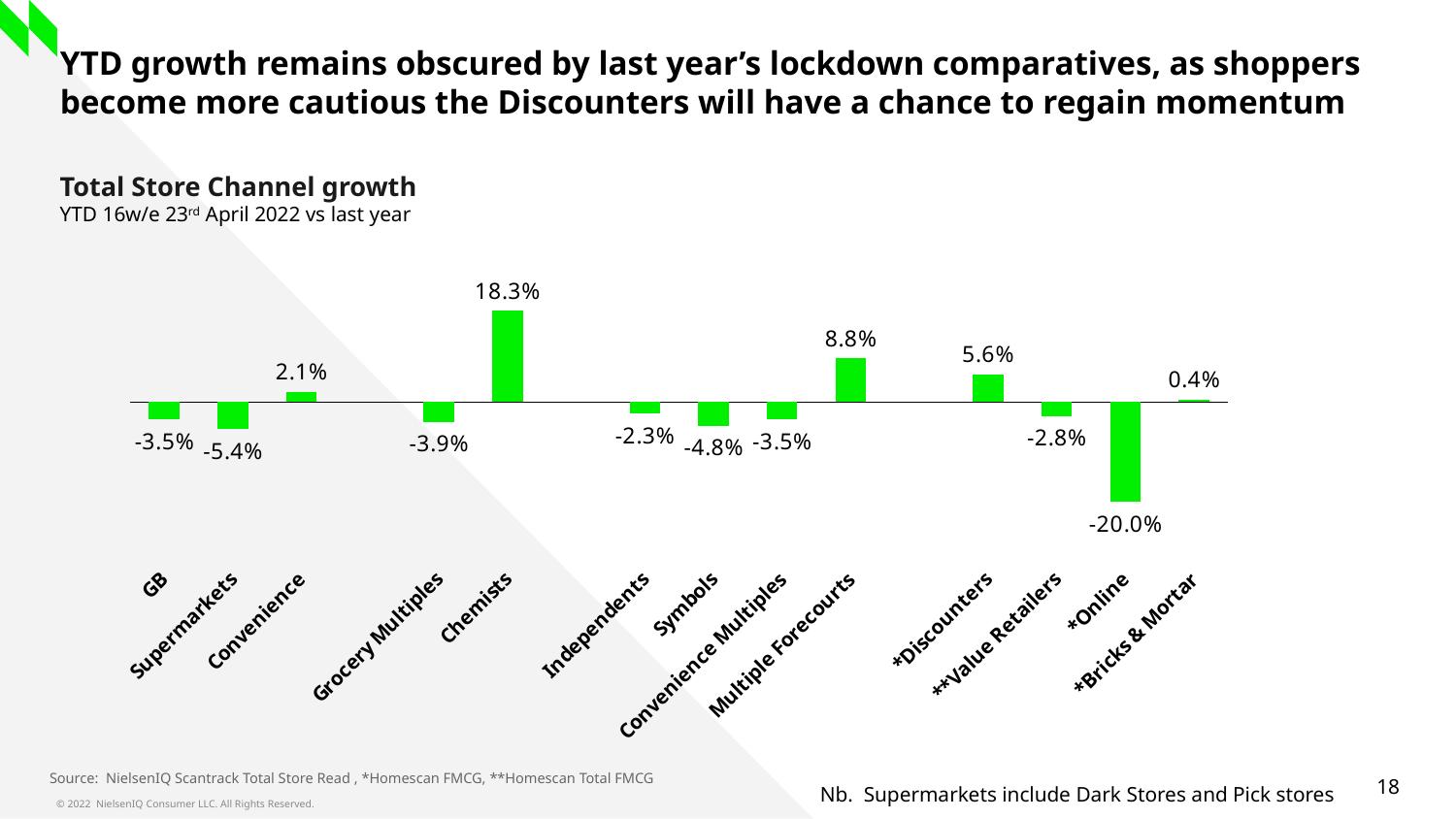
What is the difference between the growth values for Multiple Forecourts and *Discounters? 3.2 percentage points Which channel has the lowest growth value? *Online What is the title of the chart? Total Store Channel growth How many channels are shown in the chart? 13 Which channel has the highest growth value? Chemists What colour are the bars in the chart? Green What kind of chart is shown on the slide? Bar chart What is the growth value for Chemists? 18.3% What is the growth value for Supermarkets? -5.4% What is the growth value for *Discounters? 5.6% What is the growth value for *Online? -20.0% Which has the larger growth value, Convenience or *Bricks & Mortar? Convenience